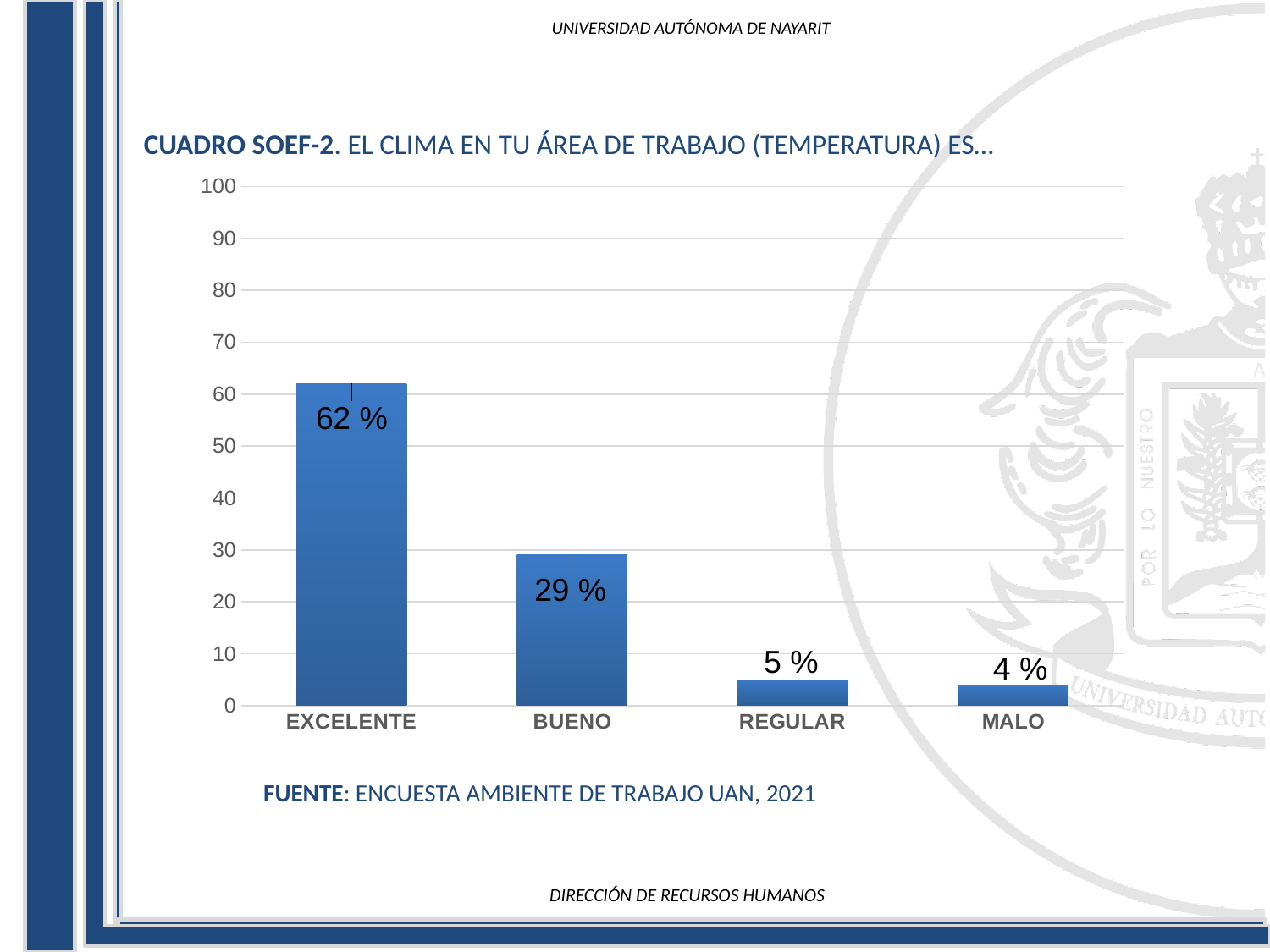
How many categories are shown on the x axis? 4 What is the value for REGULAR? 5 % What is the value for EXCELENTE? 62 % Which category has the lowest value? MALO Which category has the highest value? EXCELENTE What kind of chart is shown on the slide? bar chart What is the value for BUENO? 29 % Is the value for EXCELENTE greater or less than 50? greater Which is larger, the value for BUENO or the value for REGULAR? BUENO What is the value for MALO? 4 % What is the difference between the values for EXCELENTE and BUENO? 33 % Do the values rise or fall from left to right along the x axis? fall